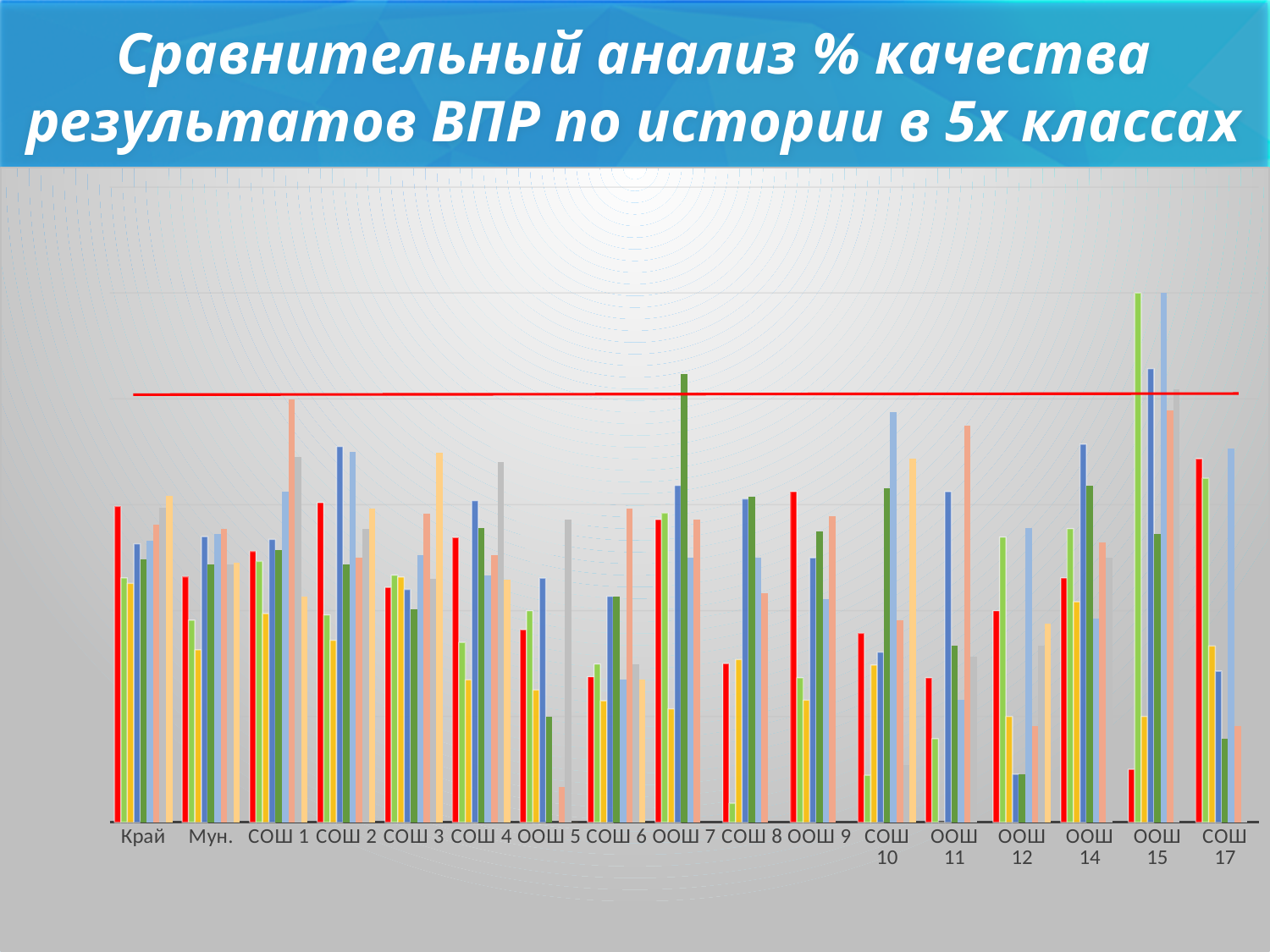
What kind of chart is shown on the slide? bar chart Which has the taller red bar, СОШ 2 or ООШ 15? СОШ 2 How many categories are shown along the x axis of the chart? 17 Which category contains the tallest bar in the chart? ООШ 15 What is the title of the slide's chart? Сравнительный анализ % качества результатов ВПР по истории в 5х классах Which has the taller red bar, ООШ 7 or СОШ 8? ООШ 7 Which has the taller red bar, СОШ 17 or Край? СОШ 17 Which category has the shortest red bar? ООШ 15 Which category is listed first on the x axis? Край